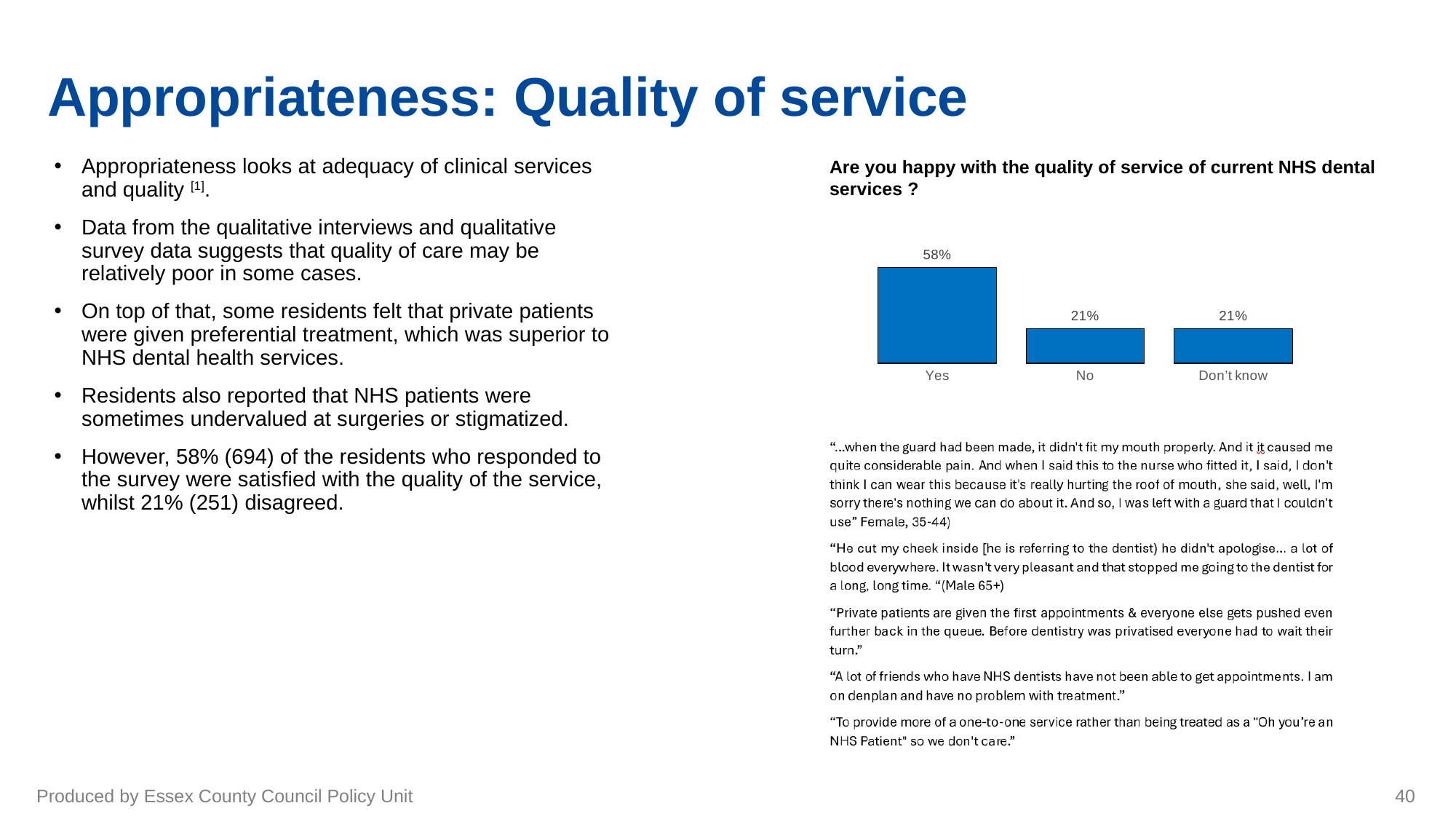
Which response category has the highest value in the chart? Yes What percentage of respondents answered Yes to being happy with the quality of service of current NHS dental services? 58% What percentage of respondents answered Don't know? 21% What question does the chart title ask? Are you happy with the quality of service of current NHS dental services? What colour are the bars in the chart? Blue What is the combined percentage of the No and Don't know responses? 42% How many response categories are shown in the chart? 3 What type of chart is used to show the survey responses? Bar chart Which is larger, the value for Yes or the value for Don't know? Yes What is the difference in percentage points between the Yes and No responses? 37 What percentage of respondents answered No? 21%